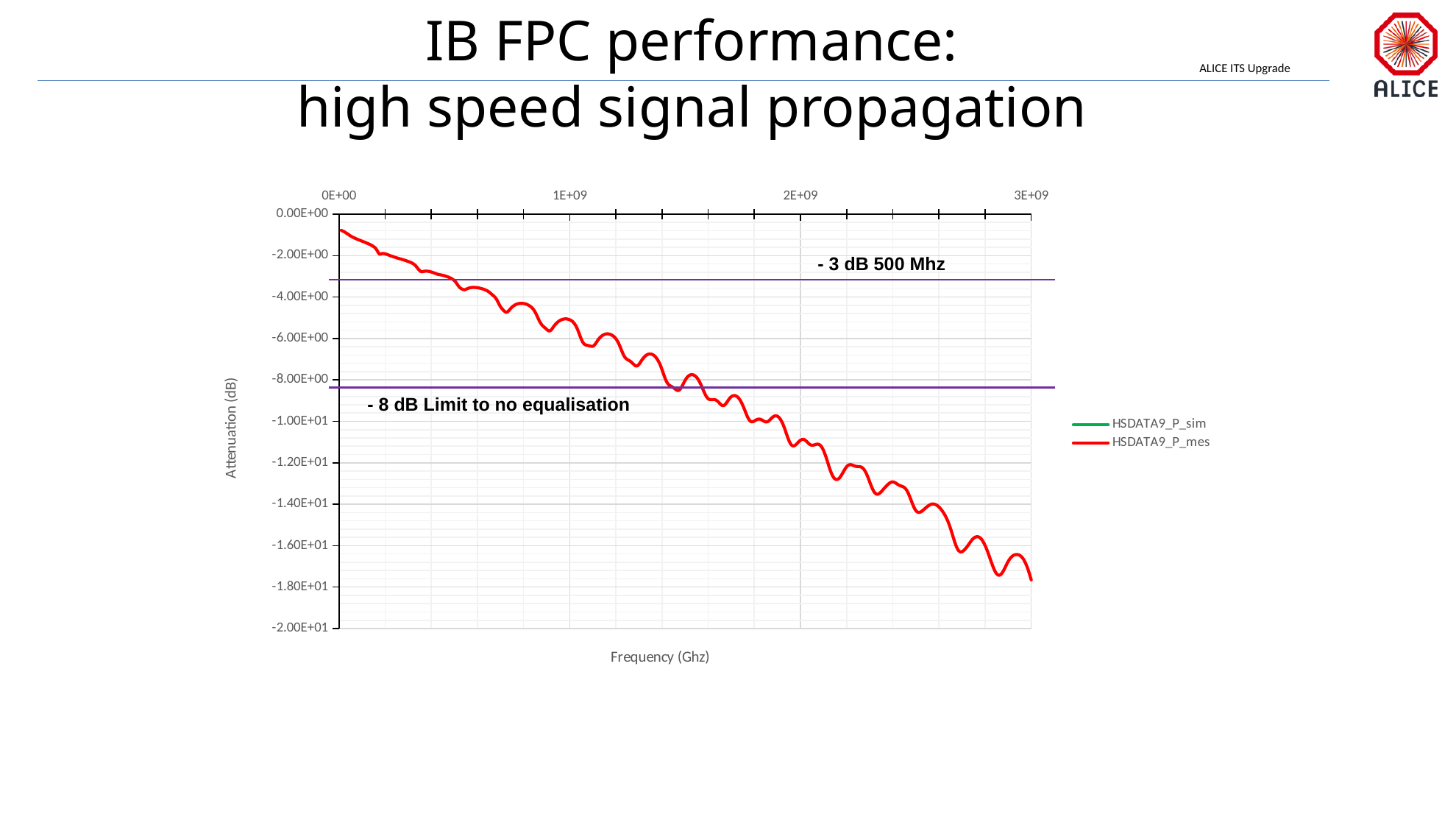
What kind of chart is shown on the slide? line chart How many series does the chart legend list? 2 What is the label of the vertical axis? Attenuation (dB) Does the HSDATA9_P_mes curve rise or fall as frequency increases along the x axis? fall What are the names of the two series listed in the legend? HSDATA9_P_sim and HSDATA9_P_mes Is the HSDATA9_P_mes value at 1E+09 greater or less than -8.00E+00? less What is the maximum frequency shown on the x axis? 3E+09 Which is larger, the HSDATA9_P_mes value at 1E+09 or at 2E+09? 1E+09 Is the HSDATA9_P_mes value at 3E+09 greater or less than -1.60E+01? less Is the HSDATA9_P_mes value at 2E+09 greater or less than -1.00E+01? less